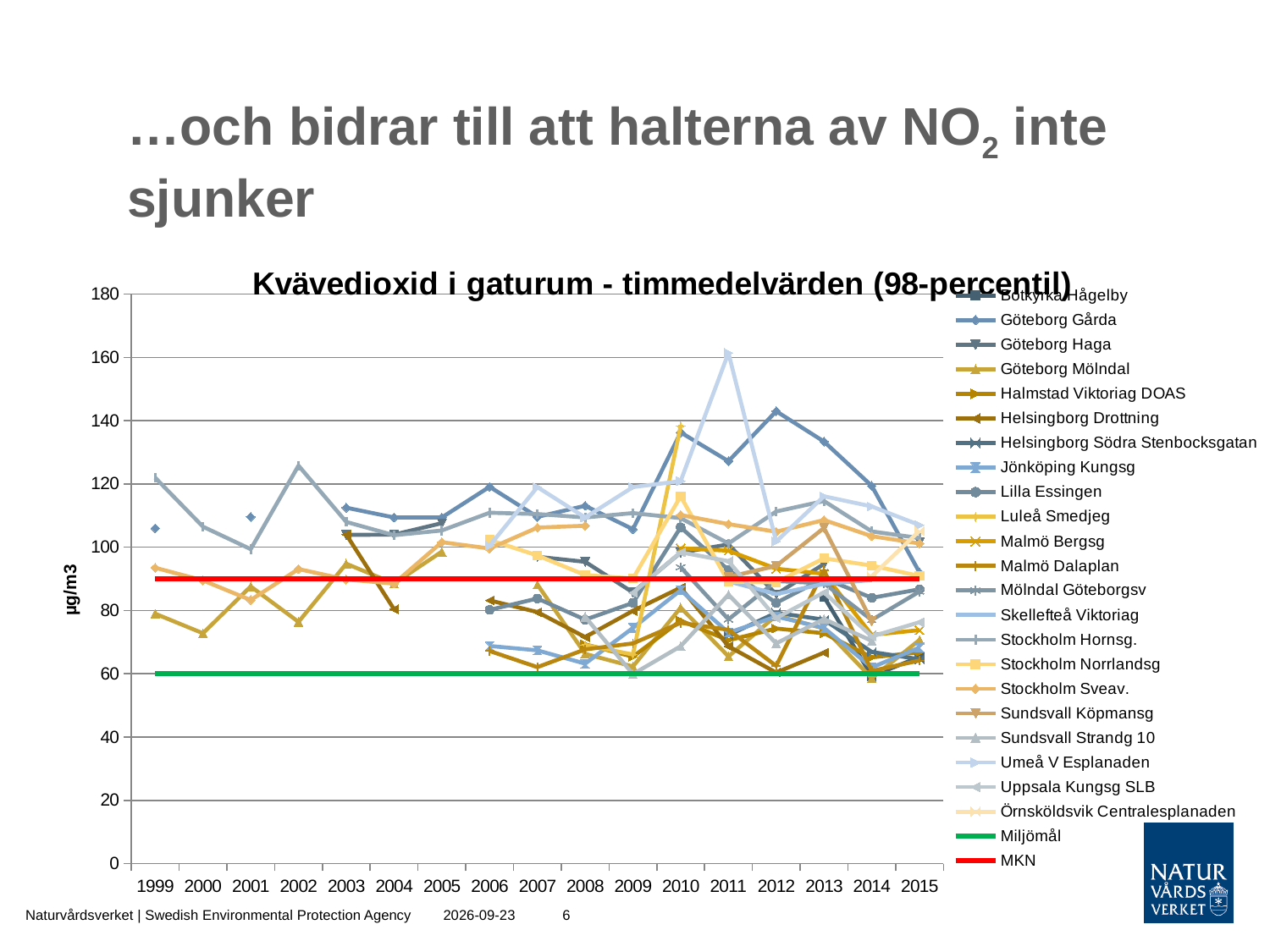
In which year does Umeå V Esplanaden reach its highest value? 2011 Is the value for Umeå V Esplanaden in 2011 greater or less than 140? greater What is the value of the Miljömål line in the chart? 60 What is the title of the chart? Kvävedioxid i gaturum - timmedelvärden (98-percentil) How many years are shown on the x axis of the chart? 17 Which series reaches the highest value anywhere in the chart? Umeå V Esplanaden Is the MKN line in the chart greater or less than 100? less Is the MKN line in the chart greater or less than 80? greater How many entries does the chart legend list? 24 What kind of chart is shown on the slide? line chart